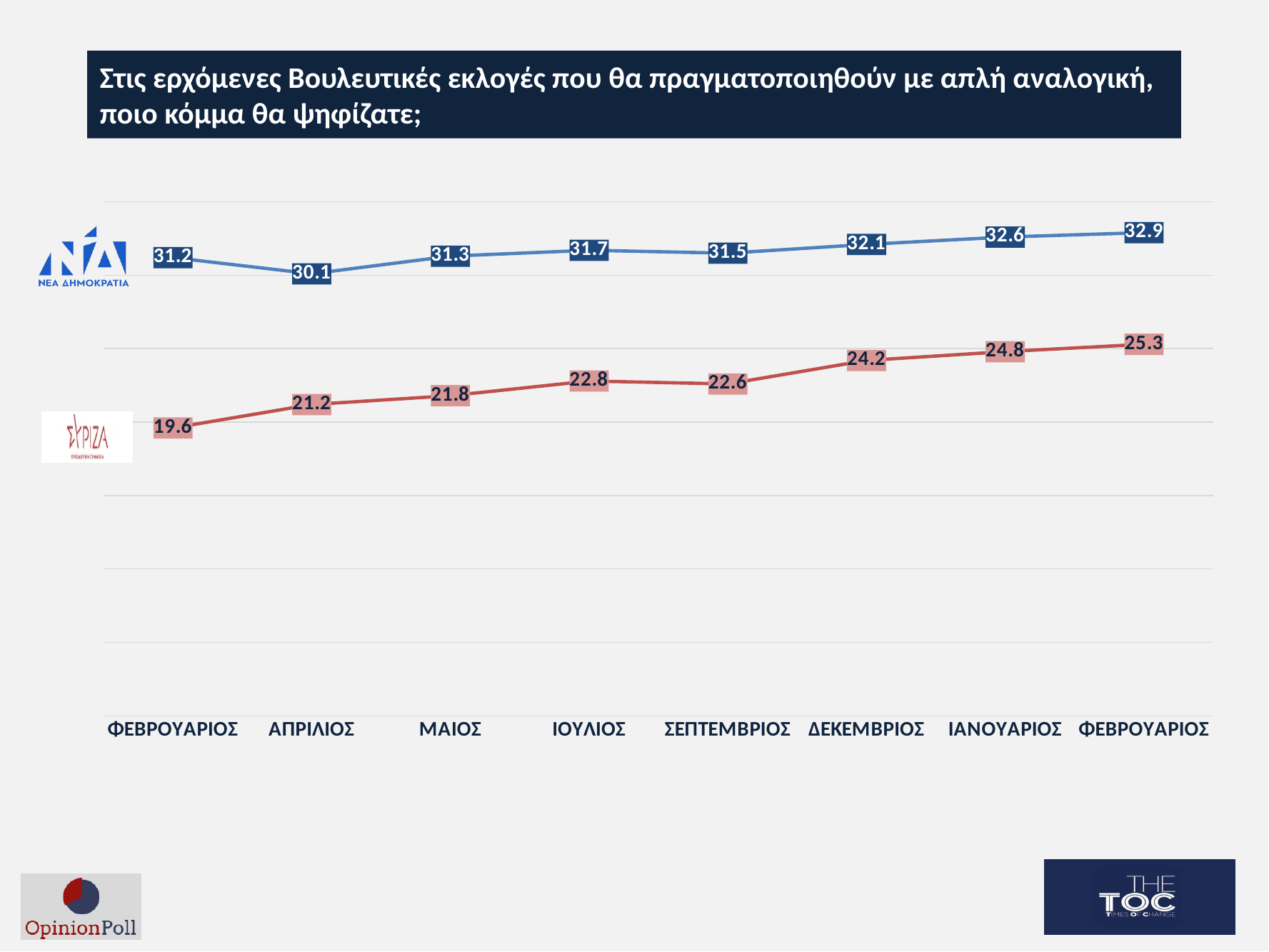
In which month does ΝΕΑ ΔΗΜΟΚΡΑΤΙΑ have its lowest value? ΑΠΡΙΛΙΟΣ How many time points are plotted on the x axis? 8 What is the highest value shown for ΣΥΡΙΖΑ? 25.3 What is the value for ΣΥΡΙΖΑ in ΙΟΥΛΙΟΣ? 22.8 What is the value for ΣΥΡΙΖΑ in ΔΕΚΕΜΒΡΙΟΣ? 24.2 What is the difference between ΝΕΑ ΔΗΜΟΚΡΑΤΙΑ and ΣΥΡΙΖΑ in ΙΑΝΟΥΑΡΙΟΣ? 7.8 Does the ΣΥΡΙΖΑ line generally rise or fall from the first ΦΕΒΡΟΥΑΡΙΟΣ to the last ΦΕΒΡΟΥΑΡΙΟΣ? Rise What is the value for ΝΕΑ ΔΗΜΟΚΡΑΤΙΑ at the last ΦΕΒΡΟΥΑΡΙΟΣ point on the right? 32.9 What type of chart is shown on the slide? Line chart What is the value for ΝΕΑ ΔΗΜΟΚΡΑΤΙΑ in ΑΠΡΙΛΙΟΣ? 30.1 In which month does ΣΥΡΙΖΑ have its lowest value? ΦΕΒΡΟΥΑΡΙΟΣ (the first point) Which party has the higher value in ΣΕΠΤΕΜΒΡΙΟΣ, ΝΕΑ ΔΗΜΟΚΡΑΤΙΑ or ΣΥΡΙΖΑ? ΝΕΑ ΔΗΜΟΚΡΑΤΙΑ